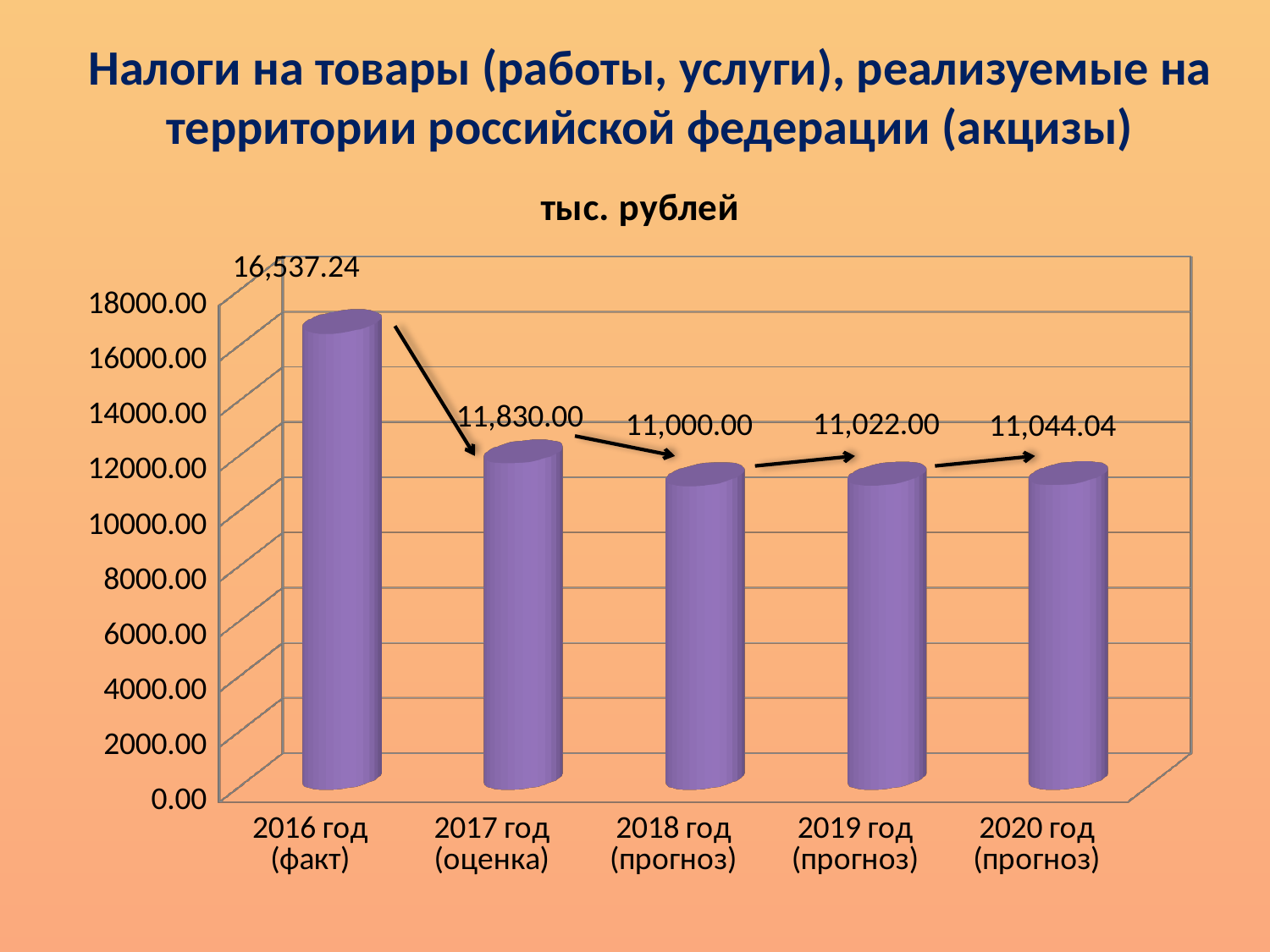
What is the difference between the values for 2016 год (факт) and 2017 год (оценка)? 4,707.24 How many categories are shown on the x axis? 5 What is the value for 2016 год (факт)? 16,537.24 What kind of chart is shown on the slide? bar chart Which category has the lowest value? 2018 год (прогноз) Do the values rise or fall from 2016 год (факт) to 2018 год (прогноз)? fall What is the difference between the values for 2017 год (оценка) and 2018 год (прогноз)? 830.00 What is the value for 2020 год (прогноз)? 11,044.04 Is the value for 2017 год (оценка) greater or less than 12000.00? less Which category has the highest value? 2016 год (факт) What is the value for 2018 год (прогноз)? 11,000.00 Which is larger, the value for 2019 год (прогноз) or 2018 год (прогноз)? 2019 год (прогноз)